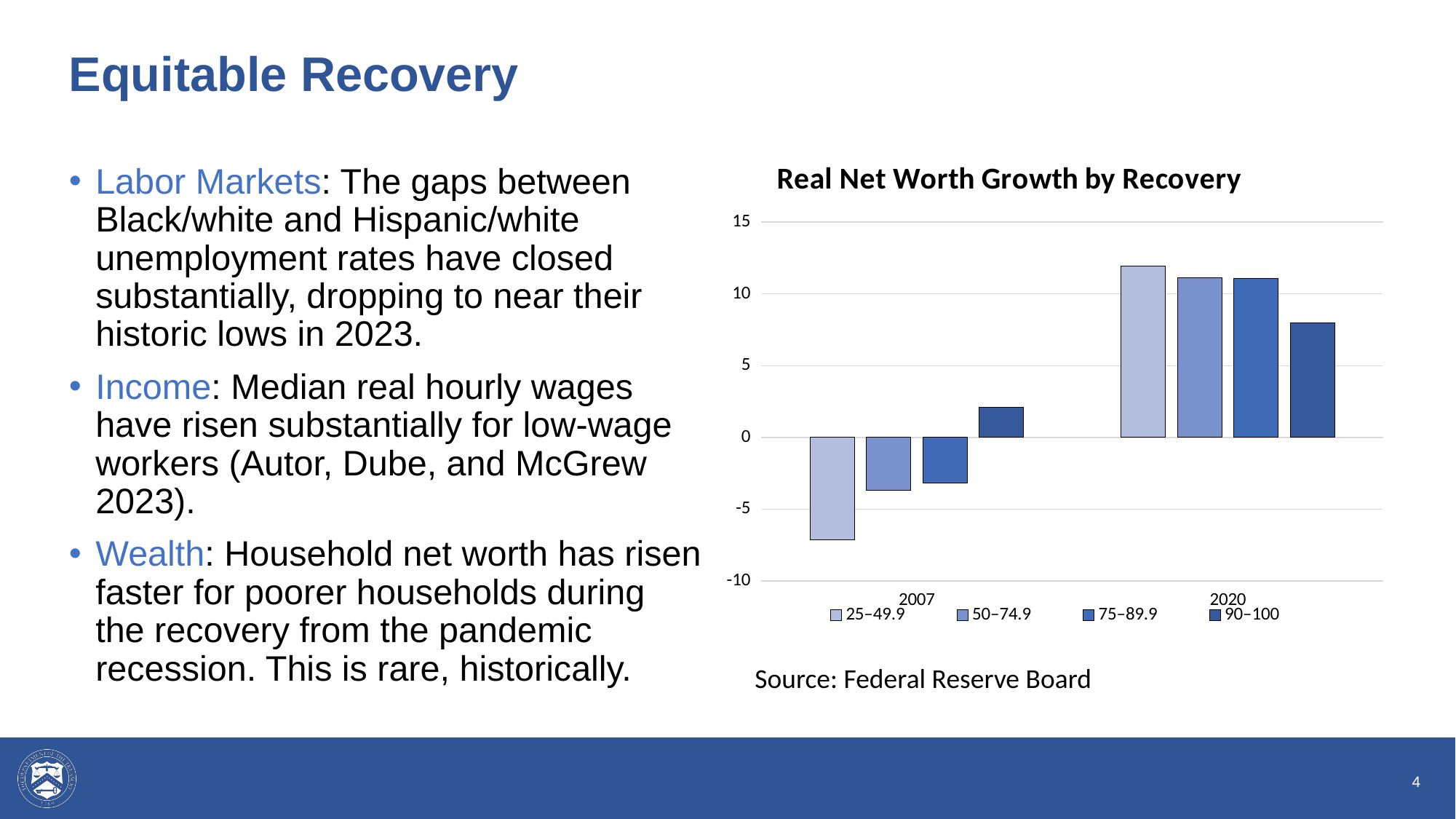
Is the value for the 25–49.9 group in 2007 greater or less than -5? less Which wealth group has the lowest value in the 2020 recovery? 90–100 In the 2020 recovery, which is larger: the value for the 25–49.9 group or the 90–100 group? 25–49.9 Is the value for the 90–100 group in 2020 greater or less than 10? less Is the value for the 25–49.9 group in 2020 greater or less than 10? greater What source is cited for the chart? Federal Reserve Board What is the title of the chart? Real Net Worth Growth by Recovery How many recovery periods (categories) are shown on the x axis? 2 What kind of chart is shown on the slide? bar chart How many series does the chart's legend list? 4 Which wealth group has the lowest value in the 2007 recovery? 25–49.9